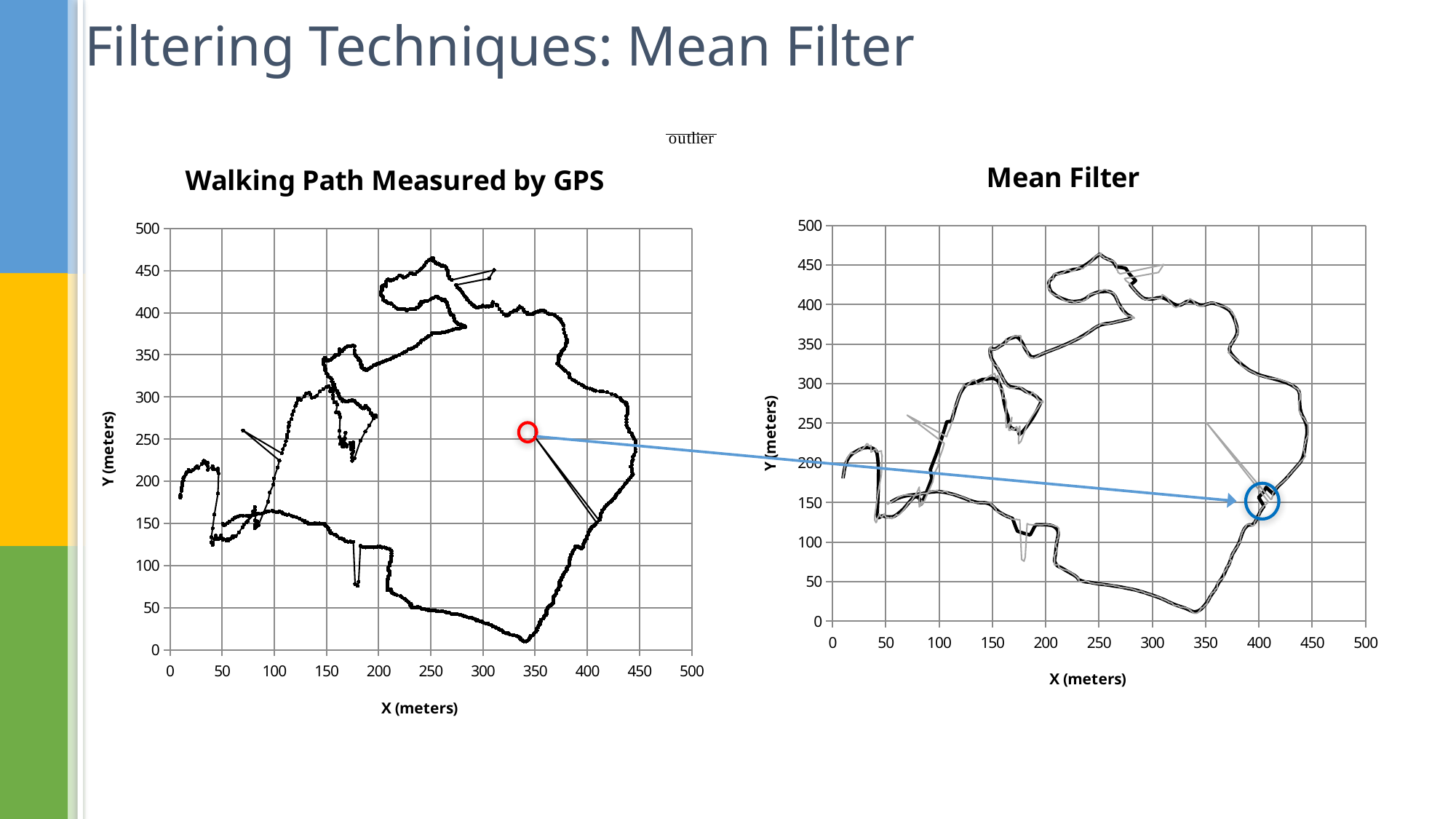
In the left chart "Walking Path Measured by GPS", is the smallest X value reached by the path greater or less than 50? less In the right chart "Mean Filter", is the largest X value reached by the path greater or less than 400? greater In the left chart "Walking Path Measured by GPS", is the highest Y value reached by the path greater or less than 400? greater What is the title of the left chart? Walking Path Measured by GPS What kind of chart is the right chart titled "Mean Filter"? scatter chart What kind of chart is the left chart titled "Walking Path Measured by GPS"? scatter chart What is the title of the right chart? Mean Filter